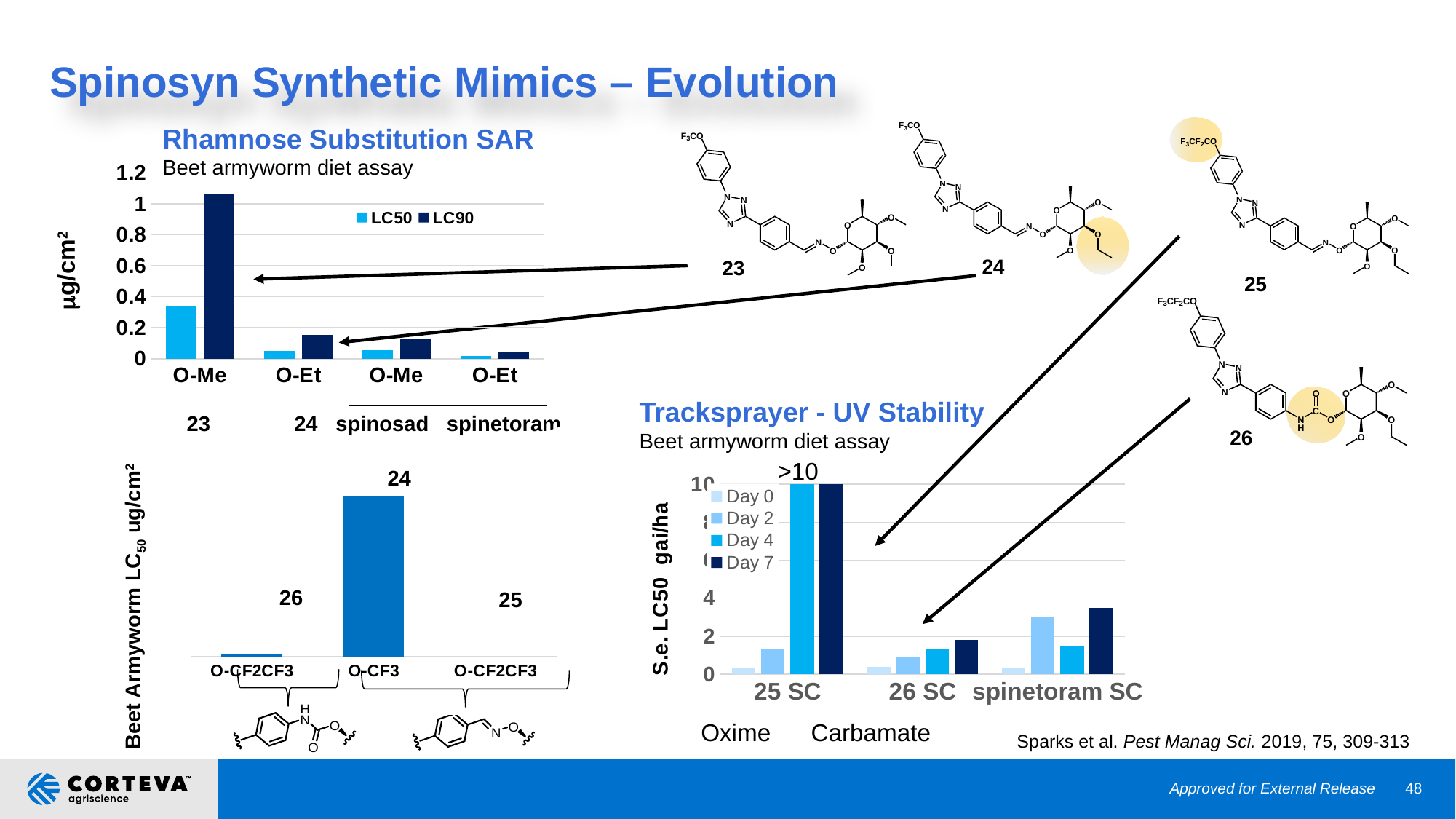
In the 'Rhamnose Substitution SAR' chart, which is larger for O-Me under 23: LC50 or LC90? LC90 In the 'Rhamnose Substitution SAR' chart, is the LC90 value for O-Me under 23 greater or less than 0.8? greater In the 'Tracksprayer - UV Stability' chart, is the Day 7 value for spinetoram SC greater or less than 2? greater In the bottom-left chart (Beet Armyworm LC50), which compound has the highest bar? 24 In the 'Rhamnose Substitution SAR' chart, which bar is the highest? LC90 for O-Me (23) In the 'Tracksprayer - UV Stability' chart, what value is labelled on the Day 4 and Day 7 bars for 25 SC? >10 What kind of chart is the 'Rhamnose Substitution SAR' chart? bar chart How many bars are plotted in the bottom-left chart (Beet Armyworm LC50)? 3 How many series does the legend of the 'Tracksprayer - UV Stability' chart list? 4 In the 'Rhamnose Substitution SAR' chart, is the LC50 value for O-Me under 23 greater or less than 0.4? less How many categories are shown on the x axis of the 'Tracksprayer - UV Stability' chart? 3 How many series does the legend of the 'Rhamnose Substitution SAR' chart list? 2